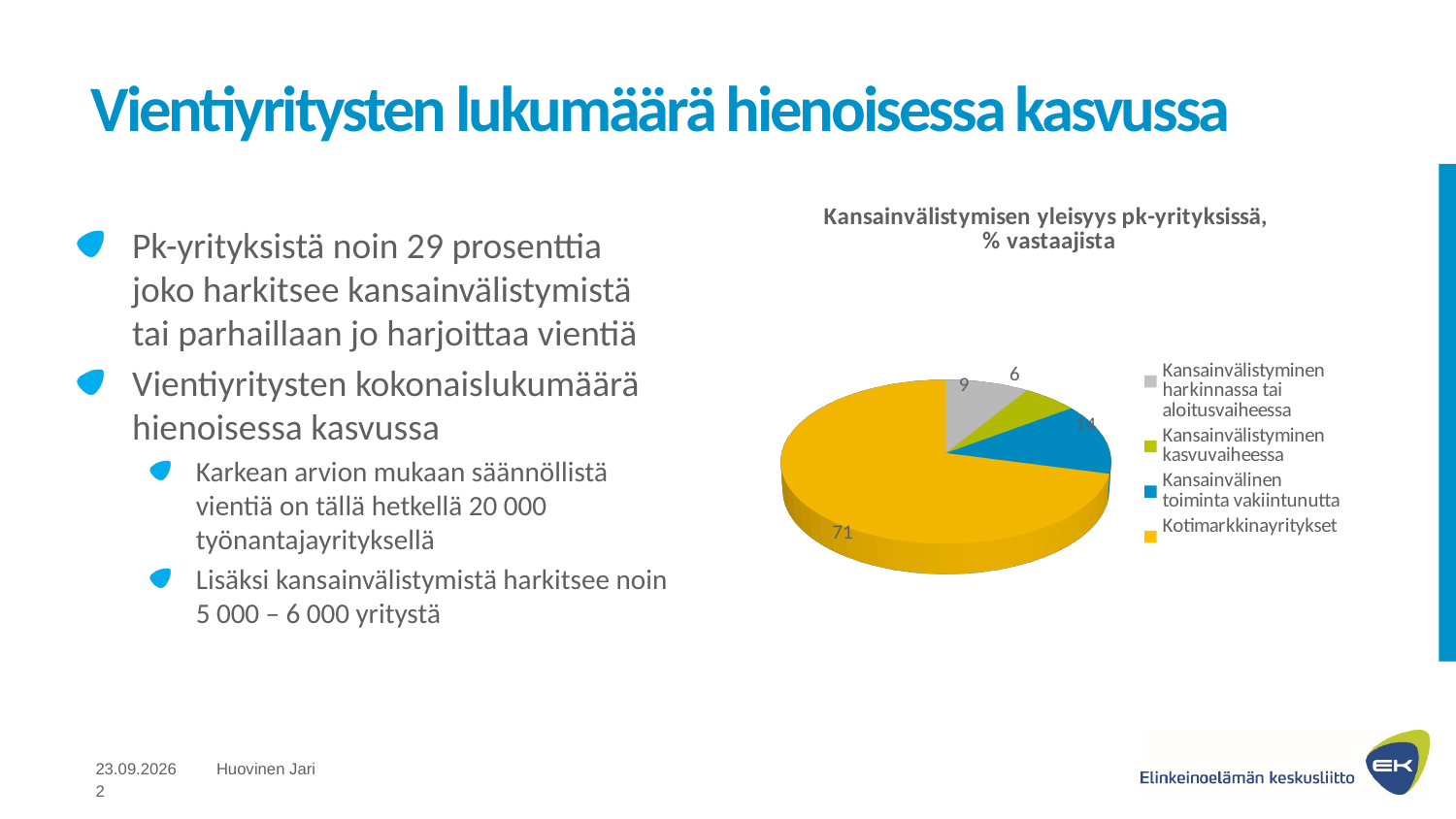
What kind of chart is shown on the slide? pie chart What is the difference between the values for Kotimarkkinayritykset and Kansainvälinen toiminta vakiintunutta? 57 What is the value for Kansainvälistyminen harkinnassa tai aloitusvaiheessa? 9 What is the value for Kansainvälinen toiminta vakiintunutta? 14 How many categories does the pie chart have? 4 Which category has the smallest slice of the pie? Kansainvälistyminen kasvuvaiheessa Which is larger, the value for Kansainvälistyminen harkinnassa tai aloitusvaiheessa or the value for Kansainvälistyminen kasvuvaiheessa? Kansainvälistyminen harkinnassa tai aloitusvaiheessa Which category has the largest slice of the pie? Kotimarkkinayritykset What colour is the slice for Kotimarkkinayritykset? yellow What is the value for Kansainvälistyminen kasvuvaiheessa? 6 What is the title of the chart? Kansainvälistymisen yleisyys pk-yrityksissä, % vastaajista What is the value for Kotimarkkinayritykset? 71